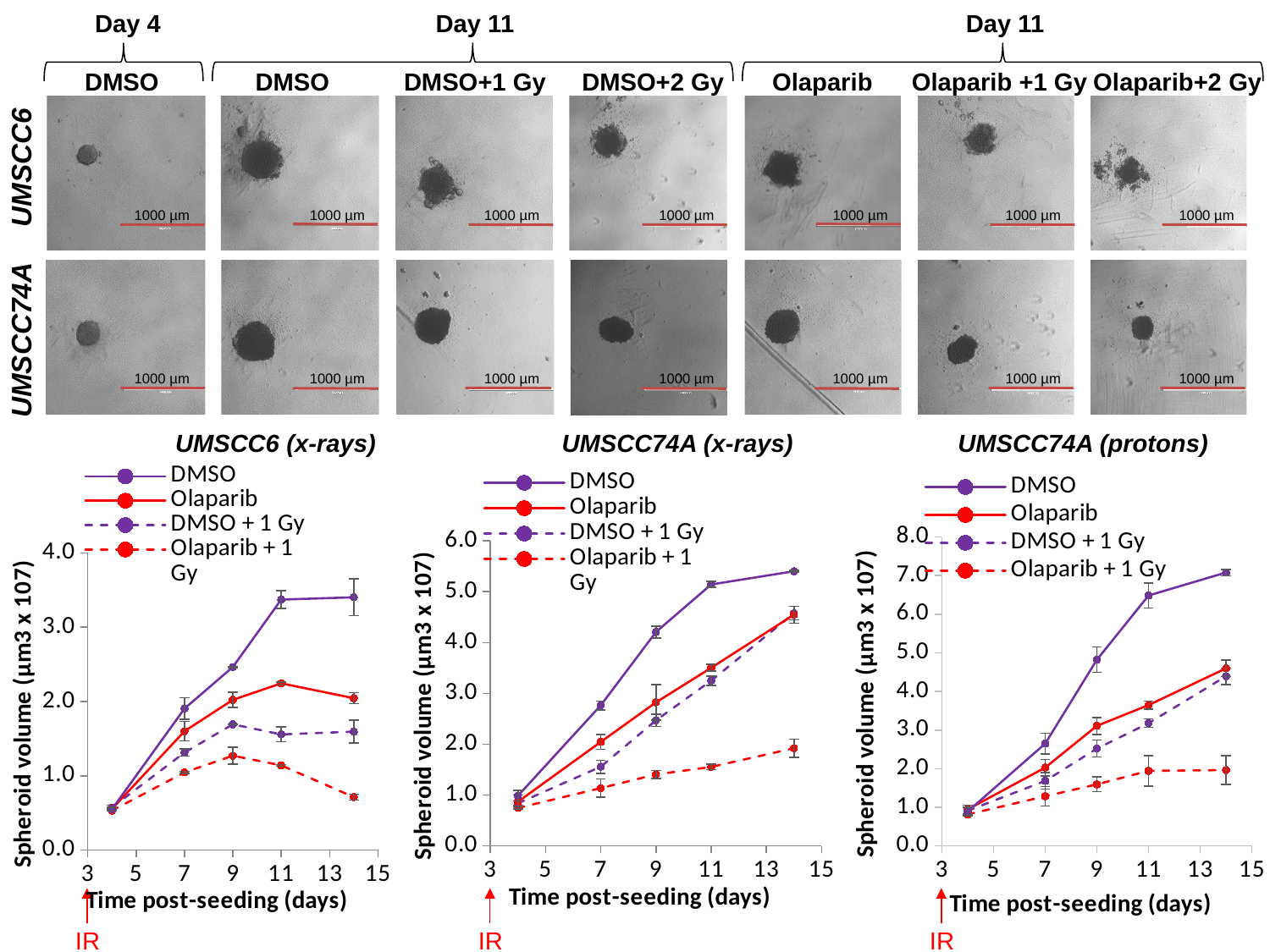
In the UMSCC6 (x-rays) chart, which series has the highest spheroid volume at day 14? DMSO In the UMSCC74A (x-rays) chart, is the DMSO value at day 14 greater or less than 5.0? greater What is the x-axis label of the UMSCC74A (x-rays) chart? Time post-seeding (days) How many series does the legend of the UMSCC74A (protons) chart list? 4 In the UMSCC6 (x-rays) chart, which is larger at day 14: the DMSO value or the Olaparib value? DMSO In the UMSCC6 (x-rays) chart, which series has the lowest spheroid volume at day 14? Olaparib + 1 Gy In the UMSCC74A (protons) chart, is the Olaparib + 1 Gy value at day 14 greater or less than 3.0? less In the UMSCC6 (x-rays) chart, how many time points are plotted for the DMSO series? 5 In the UMSCC74A (x-rays) chart, which is larger at day 11: the DMSO value or the Olaparib + 1 Gy value? DMSO What kind of chart is the UMSCC6 (x-rays) chart? line chart In the UMSCC74A (protons) chart, does the DMSO series rise or fall from day 4 to day 14? rise In the UMSCC6 (x-rays) chart, is the DMSO value at day 14 greater or less than 3.0? greater